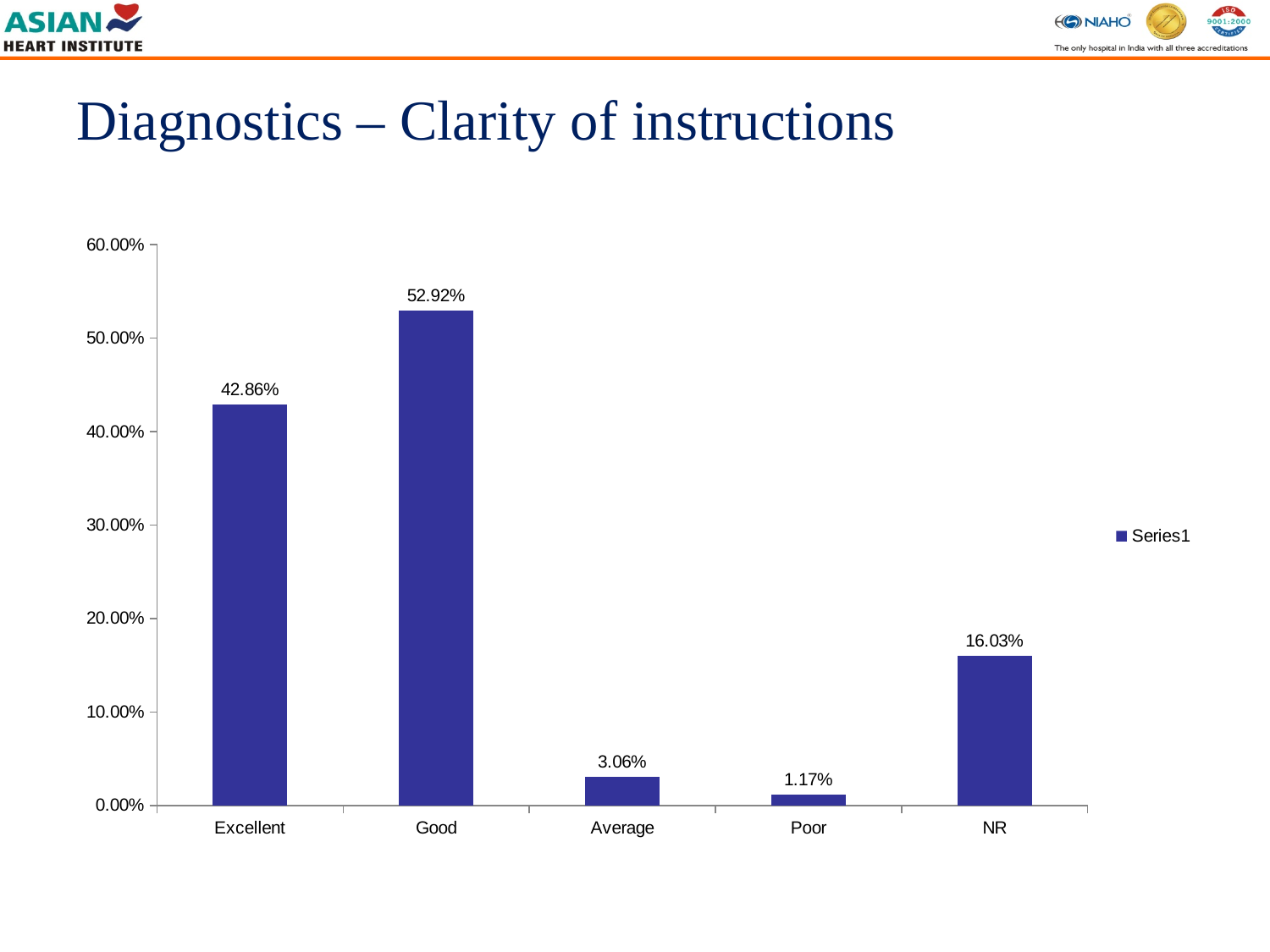
Which category has the highest value? Good What is the value for NR? 16.03% Which is larger, the value for Average or the value for NR? NR What is the value for Excellent? 42.86% What is the value for Poor? 1.17% What kind of chart is shown on the slide? bar chart Which category has the lowest value? Poor Is the value for Excellent greater or less than 40.00%? greater How many categories are shown on the x axis? 5 What is the title of the slide? Diagnostics – Clarity of instructions What is the difference between the values for Good and Excellent? 10.06% What is the value for Good? 52.92%